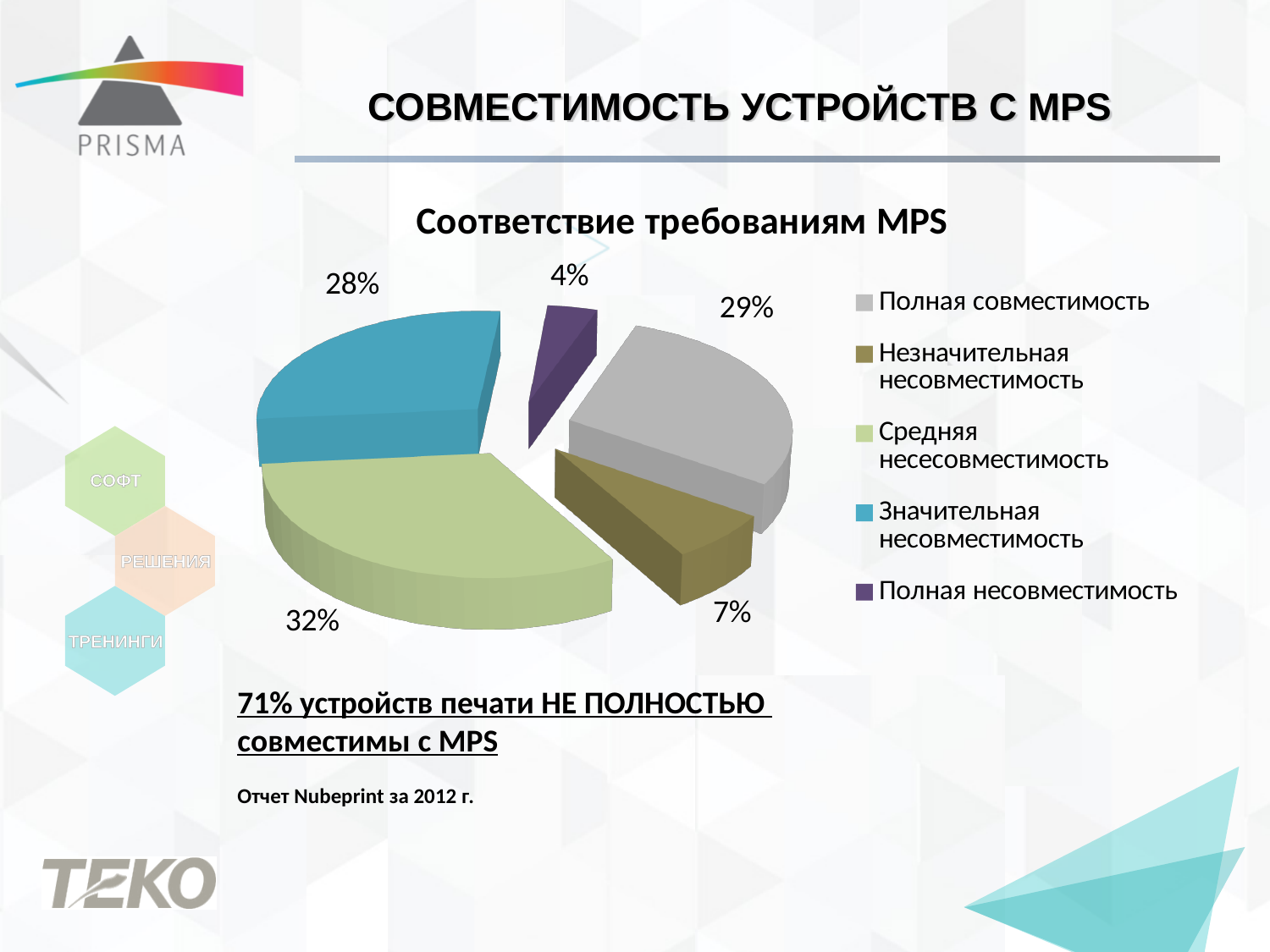
What share of the pie is labelled "Значительная несовместимость"? 28% How many slices does the pie chart have? 5 What share of the pie is labelled "Незначительная несовместимость"? 7% How many entries does the legend list? 5 What share of the pie is labelled "Полная несовместимость"? 4% What is the difference between the shares for "Полная совместимость" and "Незначительная несовместимость"? 22% What kind of chart is shown on the slide? pie chart Which category has the largest share of the pie? Средняя несесовместимость Which category has the smallest share of the pie? Полная несовместимость What is the title of the chart? Соответствие требованиям MPS